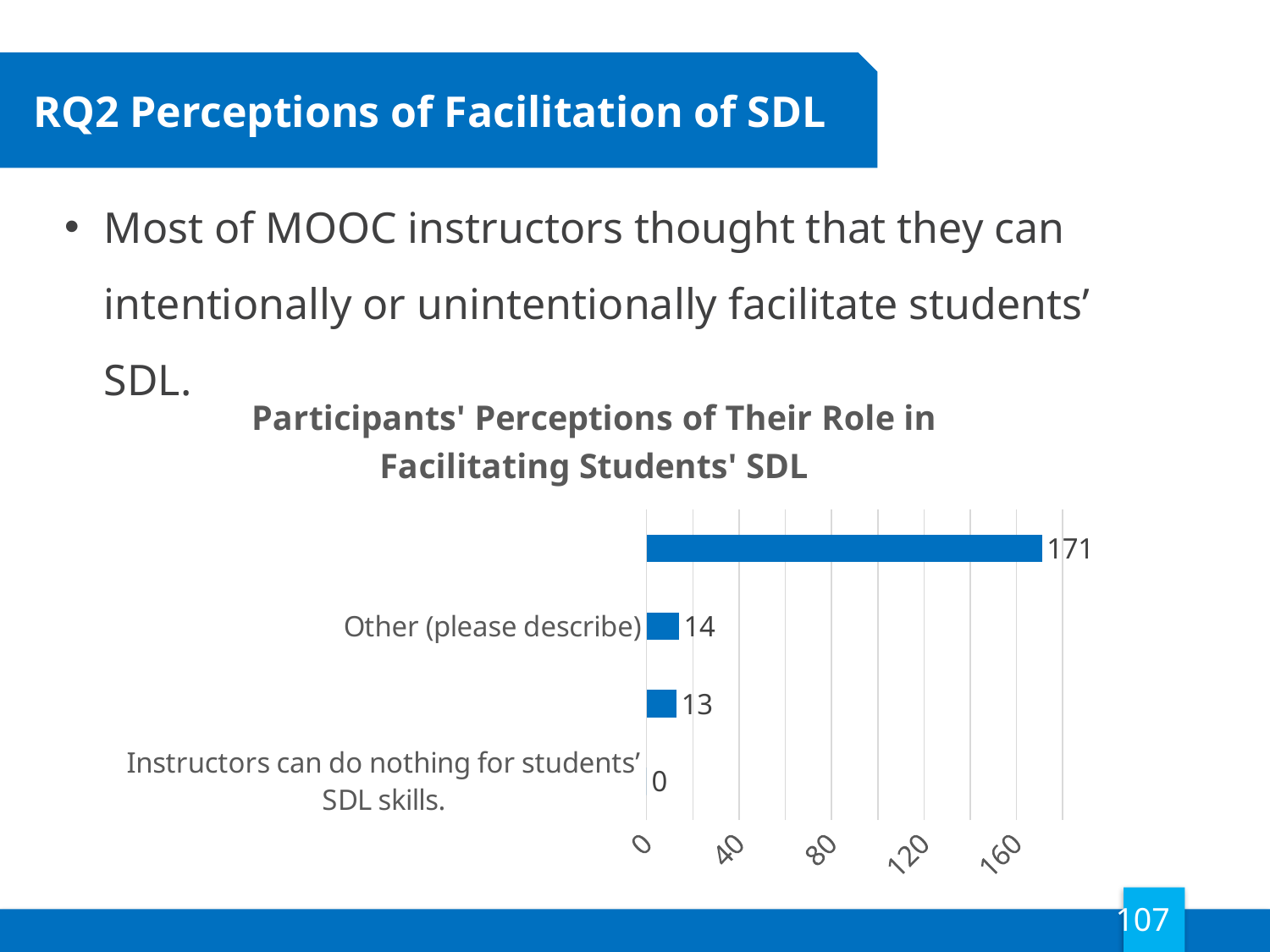
What is the difference between the largest value on the chart and the value for "Other (please describe)"? 157 What is the largest value shown on the chart? 171 What is the value for "Other (please describe)"? 14 Is the value for "Other (please describe)" greater or less than 40? less What kind of chart is shown on the slide? Bar chart Is the largest value on the chart greater or less than 160? greater What is the value for "Instructors can do nothing for students' SDL skills."? 0 What is the title of the chart? Participants' Perceptions of Their Role in Facilitating Students' SDL What is the smallest value shown on the chart? 0 How many bars are plotted on the chart? 4 What is the highest tick value shown on the horizontal axis? 160 Which is larger: the value for "Other (please describe)" or the value for "Instructors can do nothing for students' SDL skills."? Other (please describe)